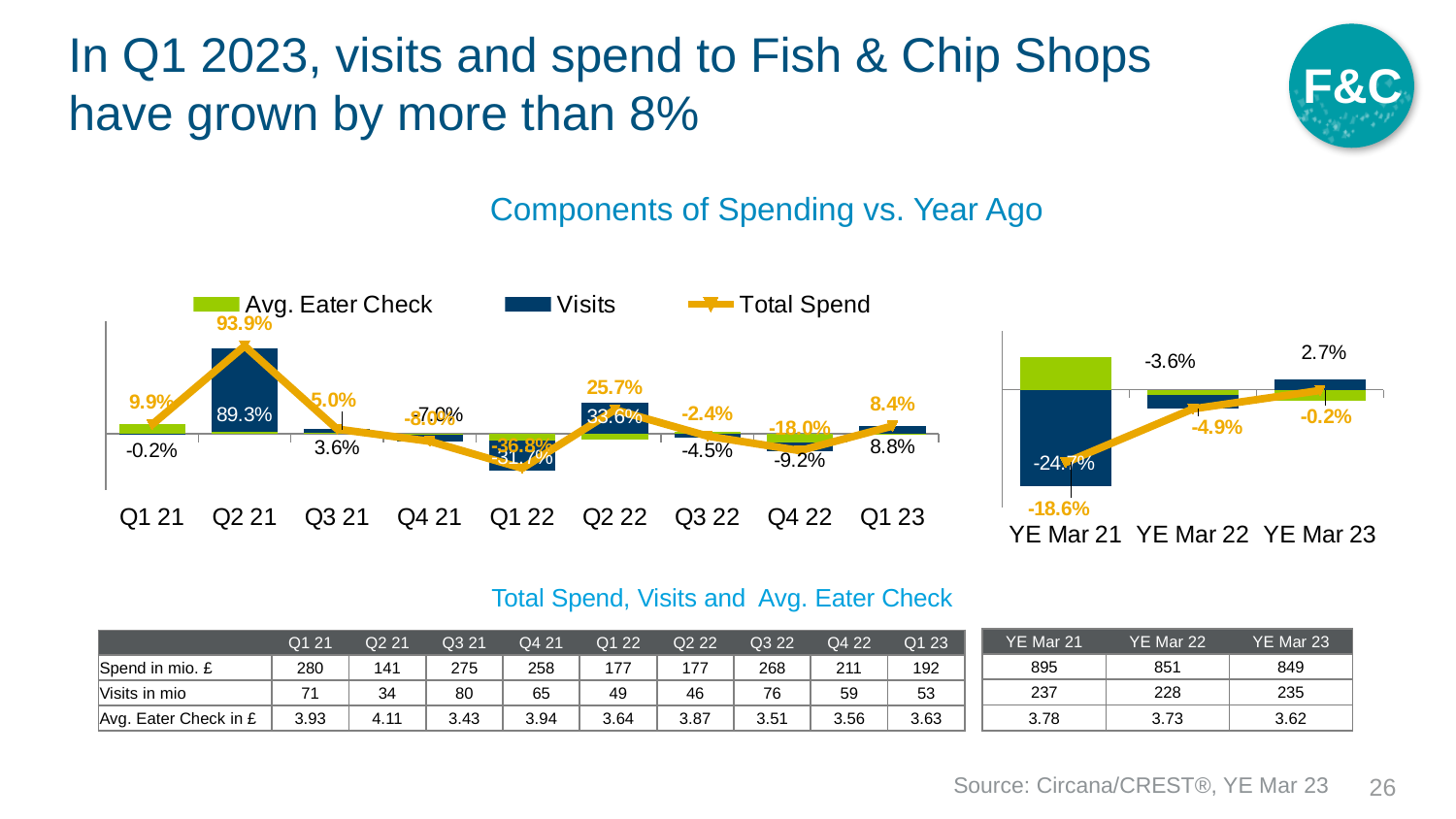
In the left chart (quarterly), which quarter has the lowest Total Spend value? Q1 22 In the right chart (year ending), how many periods are shown on the x axis? 3 Which series is plotted as a line rather than bars in the charts? Total Spend In the right chart (year ending), does the Total Spend line rise or fall from YE Mar 21 to YE Mar 23? rises In the left chart (quarterly), what is the Visits value for Q2 21? 89.3% In the left chart (quarterly), which is larger: the Total Spend value for Q2 21 or for Q2 22? Q2 21 How many series does the legend list for the charts on the slide? 3 In the right chart (year ending), what is the Total Spend value for YE Mar 21? -18.6% In the left chart (quarterly), how many quarters are shown on the x axis? 9 In the left chart (quarterly), which quarter has the highest Total Spend value? Q2 21 In the left chart (quarterly), what is the Total Spend value for Q1 23? 8.4% In the left chart (quarterly), what is the Total Spend value for Q2 21? 93.9%